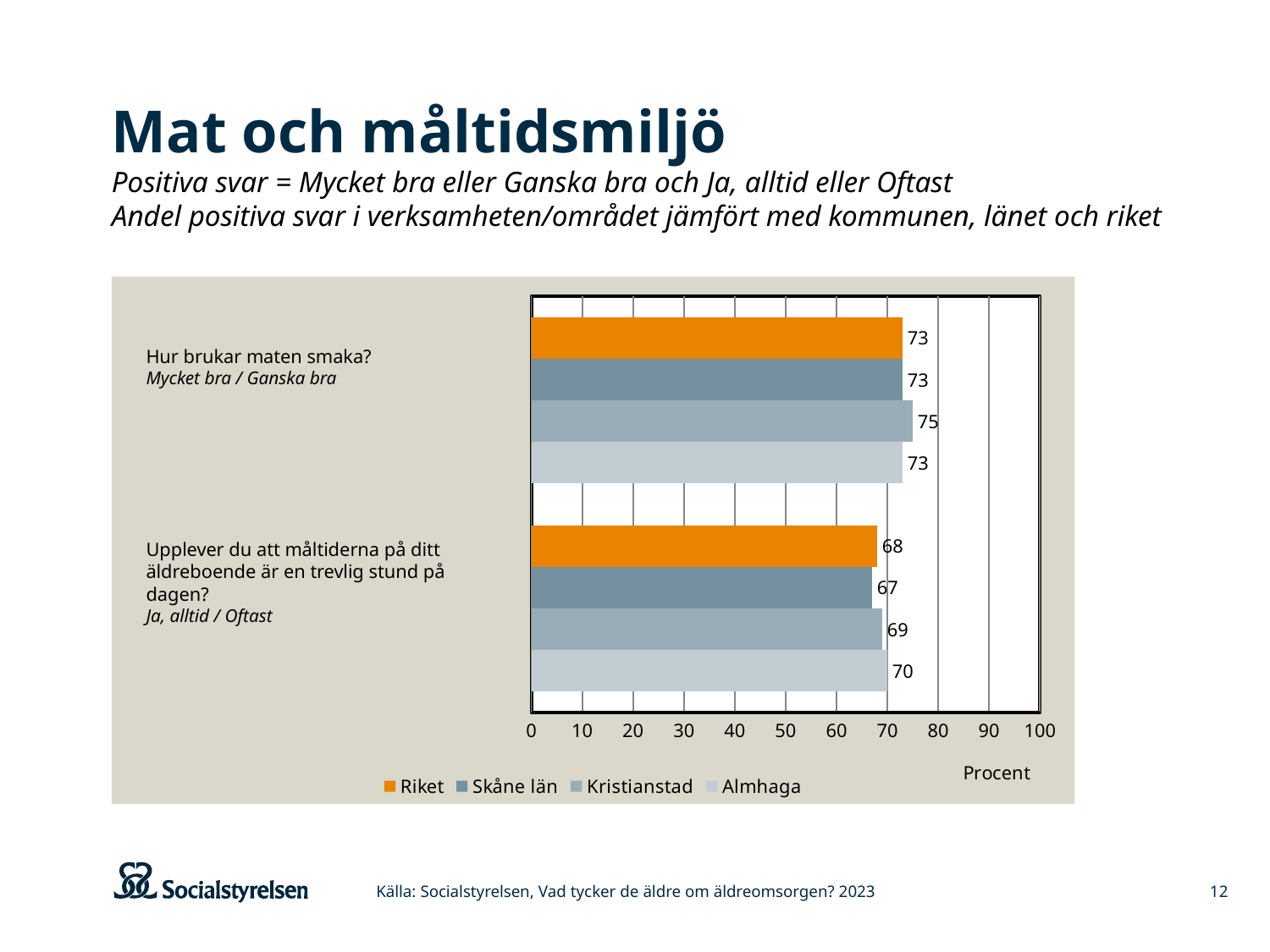
What is the value for Skåne län for the question "Upplever du att måltiderna på ditt äldreboende är en trevlig stund på dagen?"? 67 What is the difference between the Almhaga values for the two questions? 3 How many series does the legend list? 4 For the question "Upplever du att måltiderna på ditt äldreboende är en trevlig stund på dagen?", which is larger: Riket or Almhaga? Almhaga What is the value for Riket for the question "Hur brukar maten smaka?"? 73 How many question categories are shown on the chart? 2 Which series has the lowest value for the question "Upplever du att måltiderna på ditt äldreboende är en trevlig stund på dagen?"? Skåne län What is the label of the x axis? Procent Which series has the highest value for the question "Hur brukar maten smaka?"? Kristianstad What kind of chart is shown on the slide? Bar chart What is the value for Almhaga for the question "Upplever du att måltiderna på ditt äldreboende är en trevlig stund på dagen?"? 70 What is the value for Kristianstad for the question "Hur brukar maten smaka?"? 75